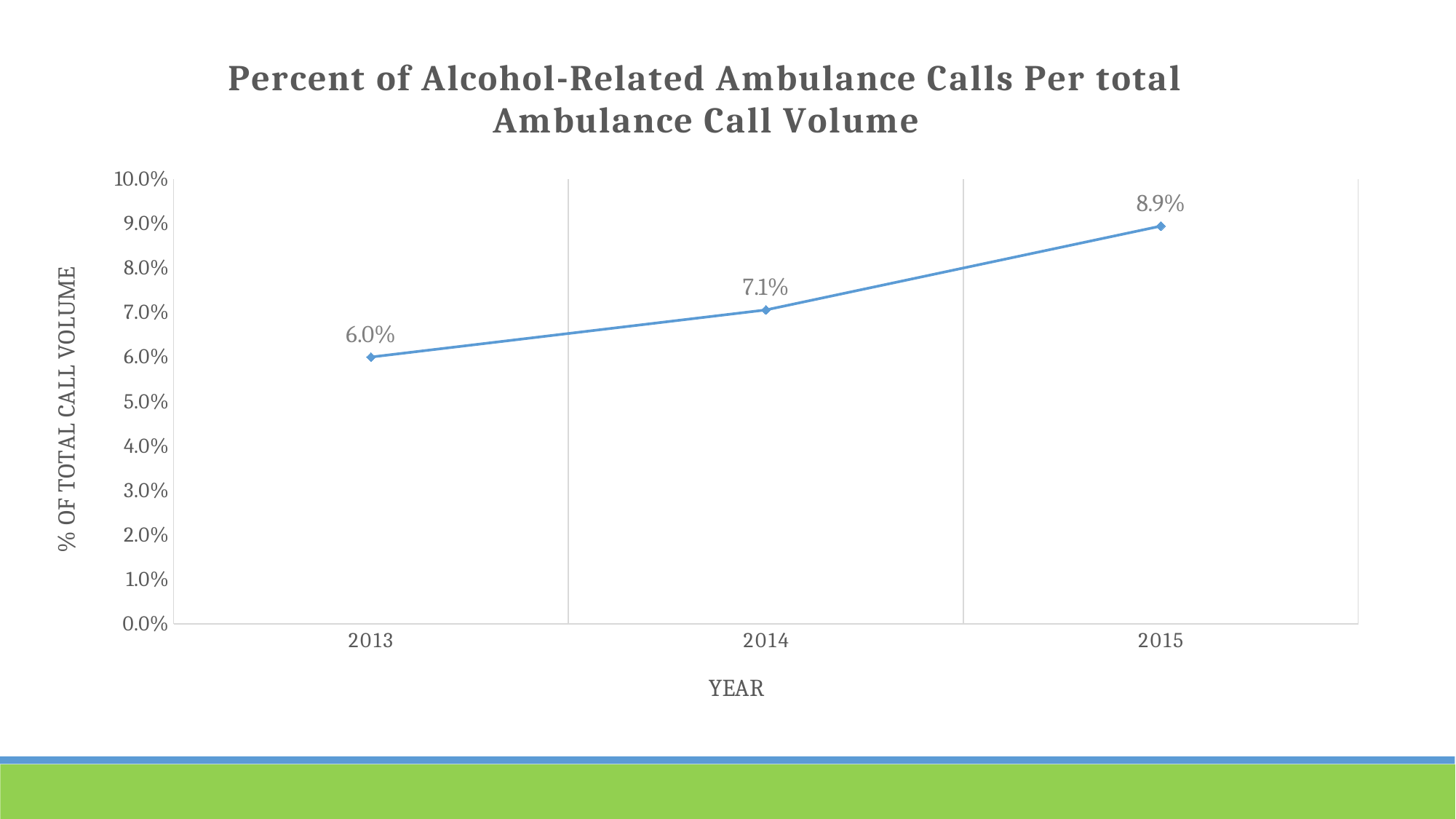
Which year has a larger value, 2014 or 2015? 2015 What kind of chart is shown on the slide? Line chart What is the percent of alcohol-related ambulance calls in 2013? 6.0% Which year has the highest percent of alcohol-related ambulance calls? 2015 Do the values rise or fall from 2013 to 2015? Rise What is the difference in percentage points between 2014 and 2013? 1.1 What is the percent of alcohol-related ambulance calls in 2014? 7.1% Is the value for 2015 greater or less than 8.0%? greater What is the percent of alcohol-related ambulance calls in 2015? 8.9% Which year has the lowest percent of alcohol-related ambulance calls? 2013 What is the difference in percentage points between 2015 and 2013? 2.9 How many years are plotted on the chart? 3